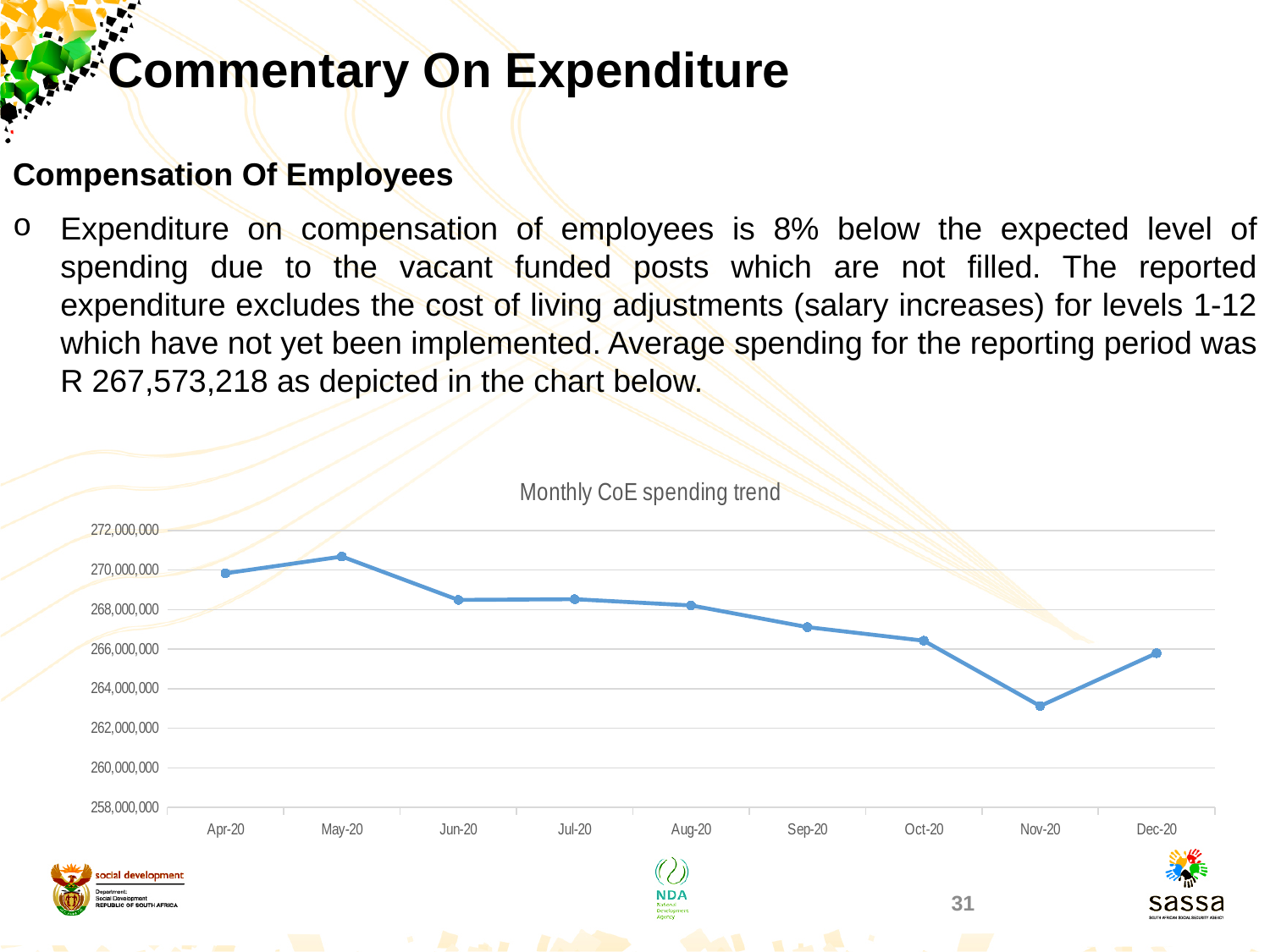
Which month has the lowest CoE spending? Nov-20 Is the value for Sep-20 greater or less than 266,000,000? greater Is the value for Dec-20 greater or less than 264,000,000? greater How many months are plotted on the chart? 9 Which month has the higher CoE spending, May-20 or Nov-20? May-20 Does CoE spending generally rise or fall from Apr-20 to Nov-20? fall What kind of chart is shown on the slide? line chart What is the title of the chart? Monthly CoE spending trend Which month has the highest CoE spending? May-20 Which month has the higher CoE spending, Aug-20 or Sep-20? Aug-20 Is the value for Nov-20 greater or less than 264,000,000? less